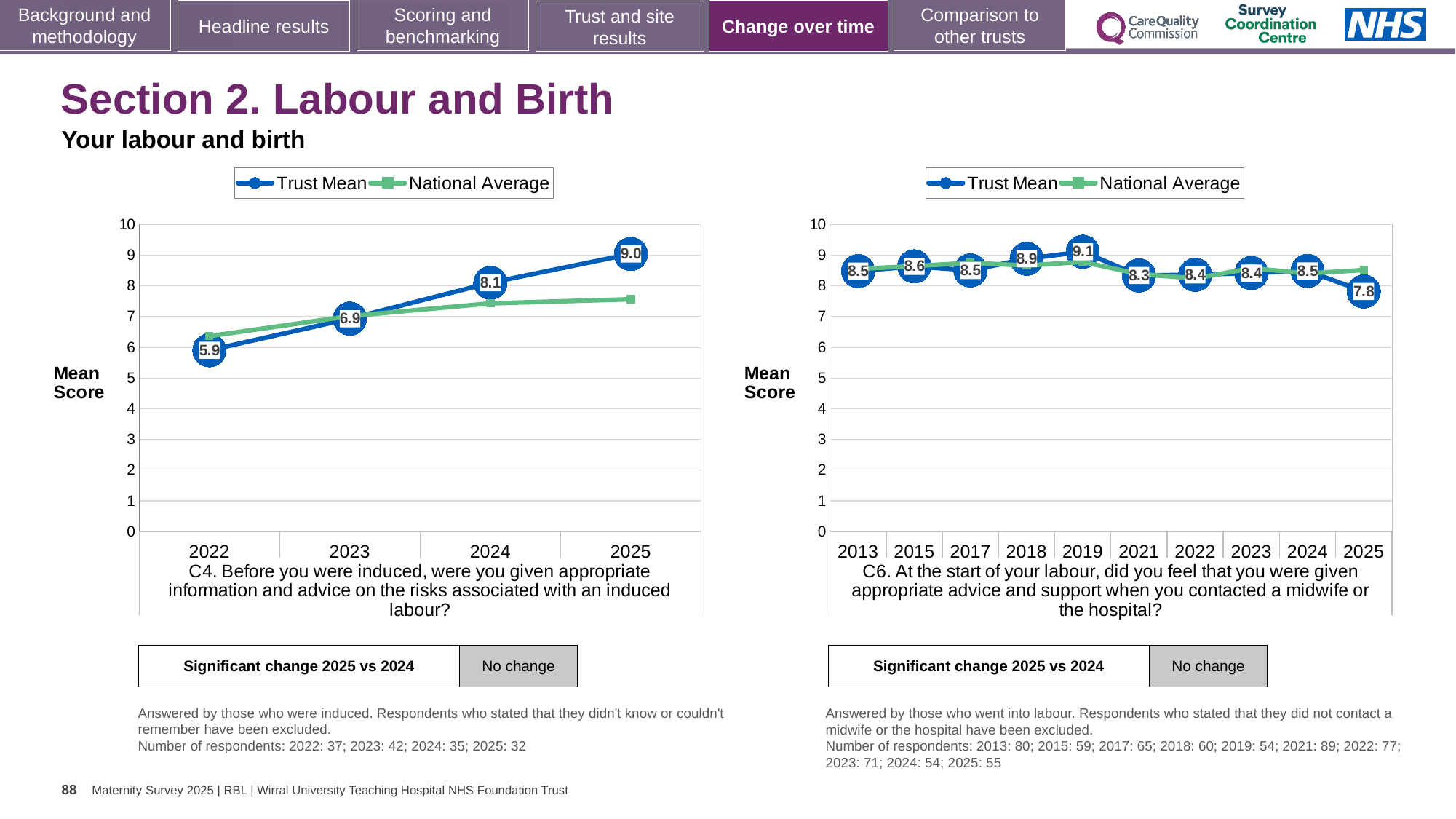
In the right chart (C6), how many years are plotted on the x axis? 10 In the left chart (C4), what is the Trust Mean for 2022? 5.9 In the left chart (C4), is the National Average for 2025 greater or less than 8? less In the right chart (C6), which year has the lowest Trust Mean? 2025 In the left chart (C4), does the Trust Mean rise or fall from 2022 to 2025? rise In the right chart (C6), which year has the highest Trust Mean? 2019 In the right chart (C6), what is the Trust Mean for 2019? 9.1 In the left chart (C4), which year has the lowest Trust Mean? 2022 How many series does the legend of the left chart (C4) list? 2 In the right chart (C6), is the Trust Mean higher in 2018 or in 2021? 2018 In the left chart (C4), what is the Trust Mean for 2025? 9.0 In the left chart (C4), what is the difference between the Trust Mean in 2025 and in 2024? 0.9